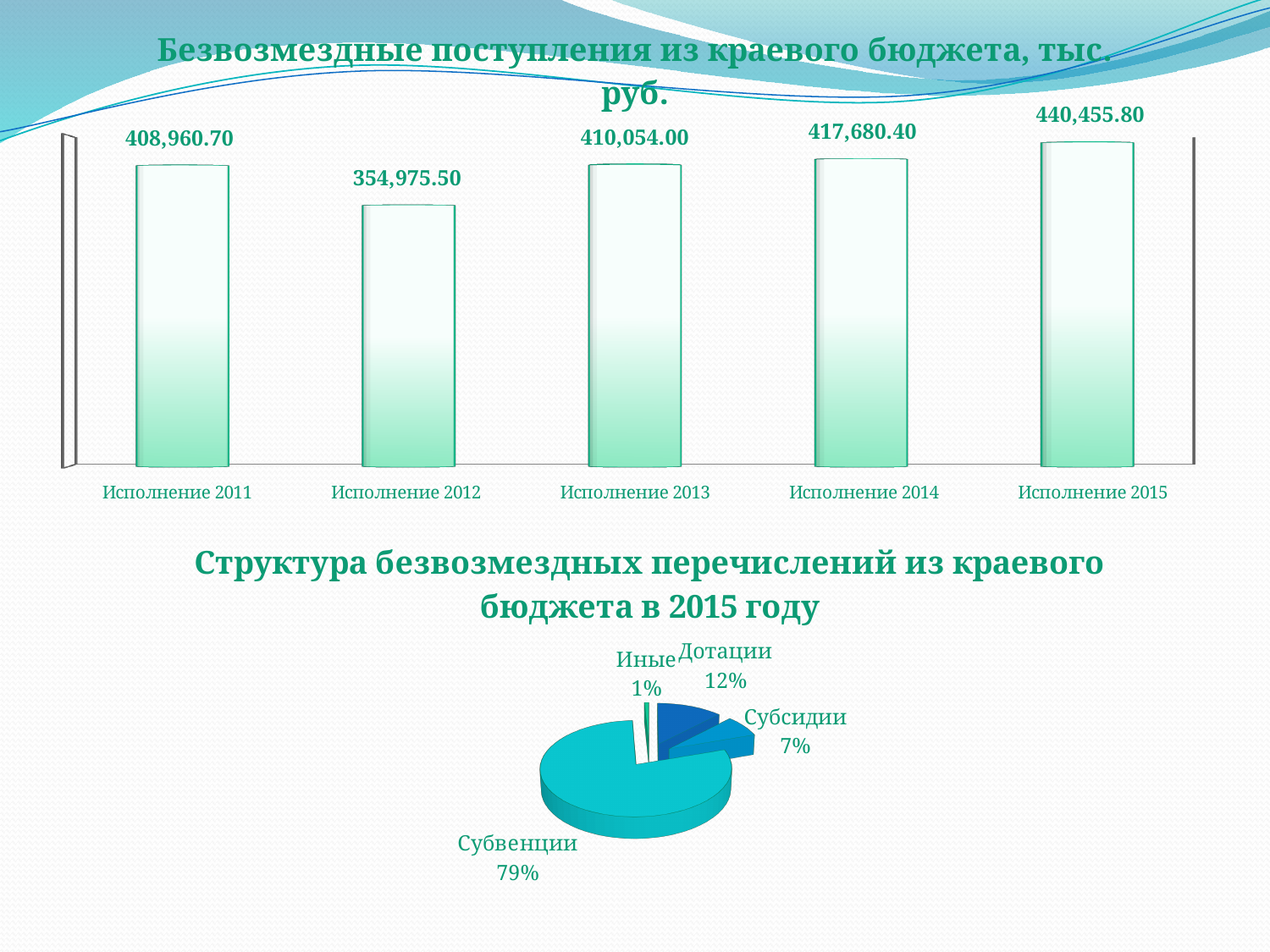
How many bars are in the top chart (Безвозмездные поступления из краевого бюджета)? 5 In the top chart (Безвозмездные поступления из краевого бюджета), what is the value for Исполнение 2013? 410,054.00 In the top chart (Безвозмездные поступления из краевого бюджета), what is the difference between the values for Исполнение 2015 and Исполнение 2012? 85,480.30 In the top chart (Безвозмездные поступления из краевого бюджета), what is the value for Исполнение 2011? 408,960.70 What kind of chart is the top chart (Безвозмездные поступления из краевого бюджета)? Bar chart In the bottom chart (Структура безвозмездных перечислений из краевого бюджета в 2015 году), what share does Субвенции have? 79% In the bottom chart (Структура безвозмездных перечислений из краевого бюджета в 2015 году), which slice is the smallest? Иные What kind of chart is the bottom chart (Структура безвозмездных перечислений из краевого бюджета в 2015 году)? Pie chart In the top chart (Безвозмездные поступления из краевого бюджета), what is the difference between the values for Исполнение 2014 and Исполнение 2013? 7,626.40 In the top chart (Безвозмездные поступления из краевого бюджета), which category has the highest value? Исполнение 2015 In the top chart (Безвозмездные поступления из краевого бюджета), which category has the lowest value? Исполнение 2012 In the top chart (Безвозмездные поступления из краевого бюджета), which is larger: the value for Исполнение 2014 or Исполнение 2012? Исполнение 2014